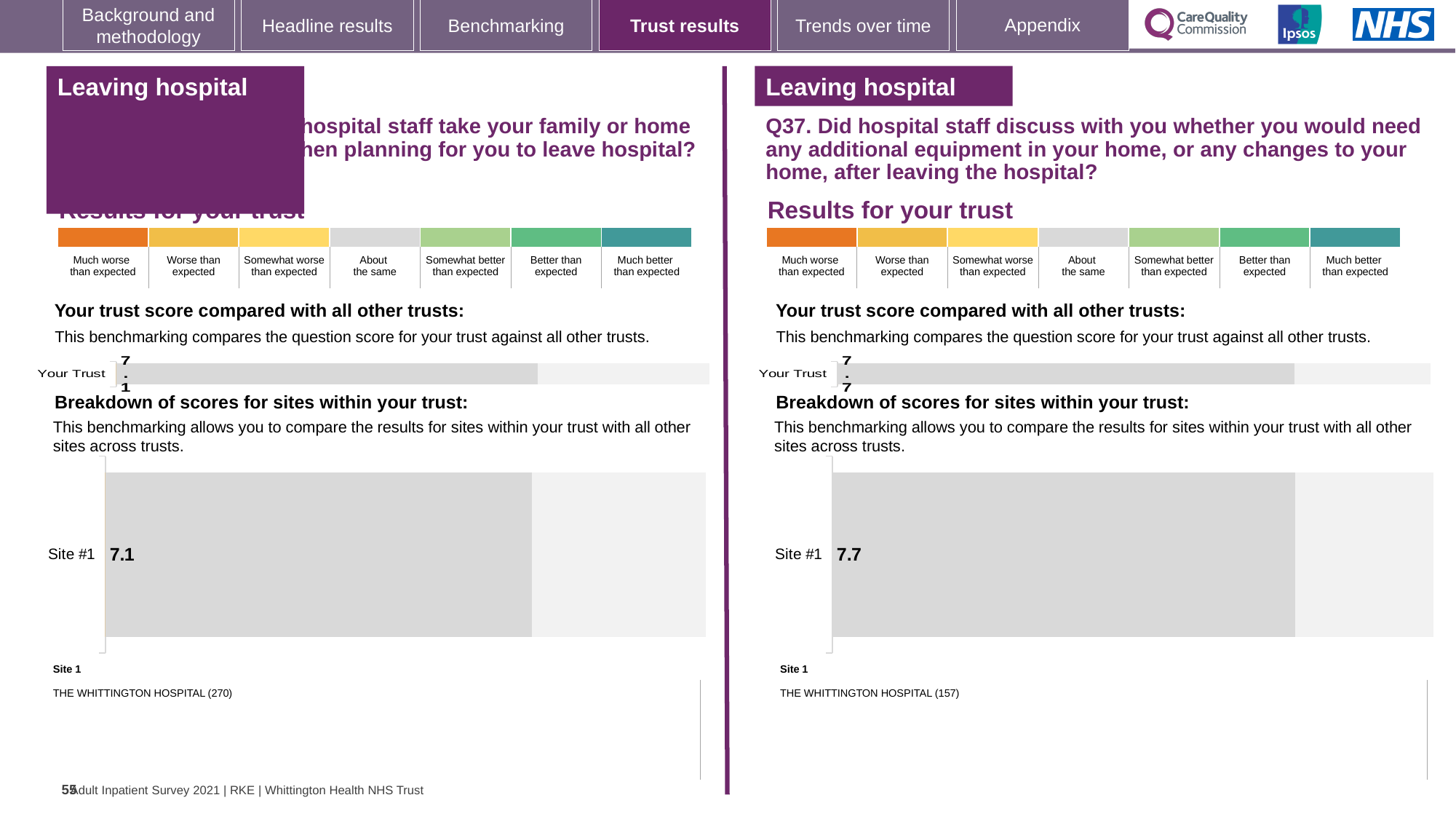
On the right-hand slide's (Q37) 'Breakdown of scores for sites within your trust' chart, what is the score for Site #1? 7.7 What kind of chart is used for the 'Breakdown of scores for sites within your trust' on the right-hand slide (Q37)? Bar chart On the left-hand slide's 'Your trust score compared with all other trusts' chart, what is the value shown for Your Trust? 7.1 What is the difference between the Site #1 score on the right-hand slide's (Q37) site breakdown chart and the Site #1 score on the left-hand slide's site breakdown chart? 0.6 How many sites are shown in the right-hand slide's (Q37) 'Breakdown of scores for sites within your trust' chart? 1 On the left-hand slide's 'Breakdown of scores for sites within your trust' chart, what is the score for Site #1? 7.1 Which is larger: the Site #1 score on the left-hand slide's site breakdown chart or the Site #1 score on the right-hand slide's (Q37) site breakdown chart? The right-hand (Q37) Site #1 score On the right-hand slide (Q37), which hospital is listed as Site 1 below the site breakdown chart? THE WHITTINGTON HOSPITAL (157) How many sites are shown in the left-hand slide's 'Breakdown of scores for sites within your trust' chart? 1 On the right-hand slide's (Q37) 'Your trust score compared with all other trusts' chart, what is the value shown for Your Trust? 7.7 On the left-hand slide, what number appears in brackets after THE WHITTINGTON HOSPITAL in the Site 1 listing? 270